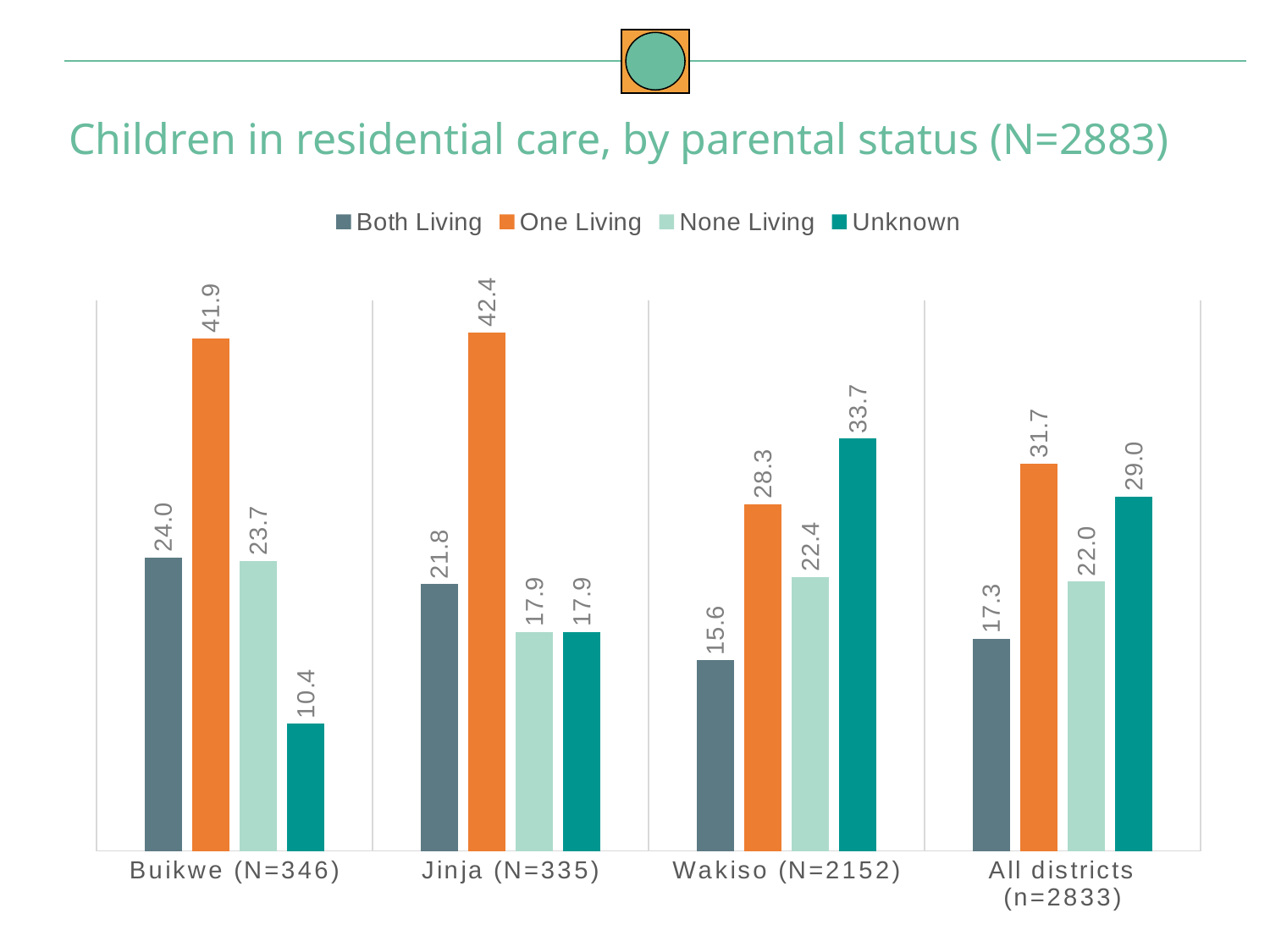
What kind of chart is shown on the slide? Bar chart Which colour represents the One Living series? Orange Which parental status category has the lowest value in Buikwe (N=346)? Unknown How many series does the legend list? 4 What is the difference between One Living and Both Living in Wakiso (N=2152)? 12.7 Which is larger in All districts (n=2833): One Living or Unknown? One Living What is the title of the chart? Children in residential care, by parental status (N=2883) What is the value for One Living in Buikwe (N=346)? 41.9 Which parental status category has the highest value in Jinja (N=335)? One Living How many districts/groups are shown on the x axis? 4 What is the value for Unknown in Wakiso (N=2152)? 33.7 What is the value for Both Living in All districts (n=2833)? 17.3